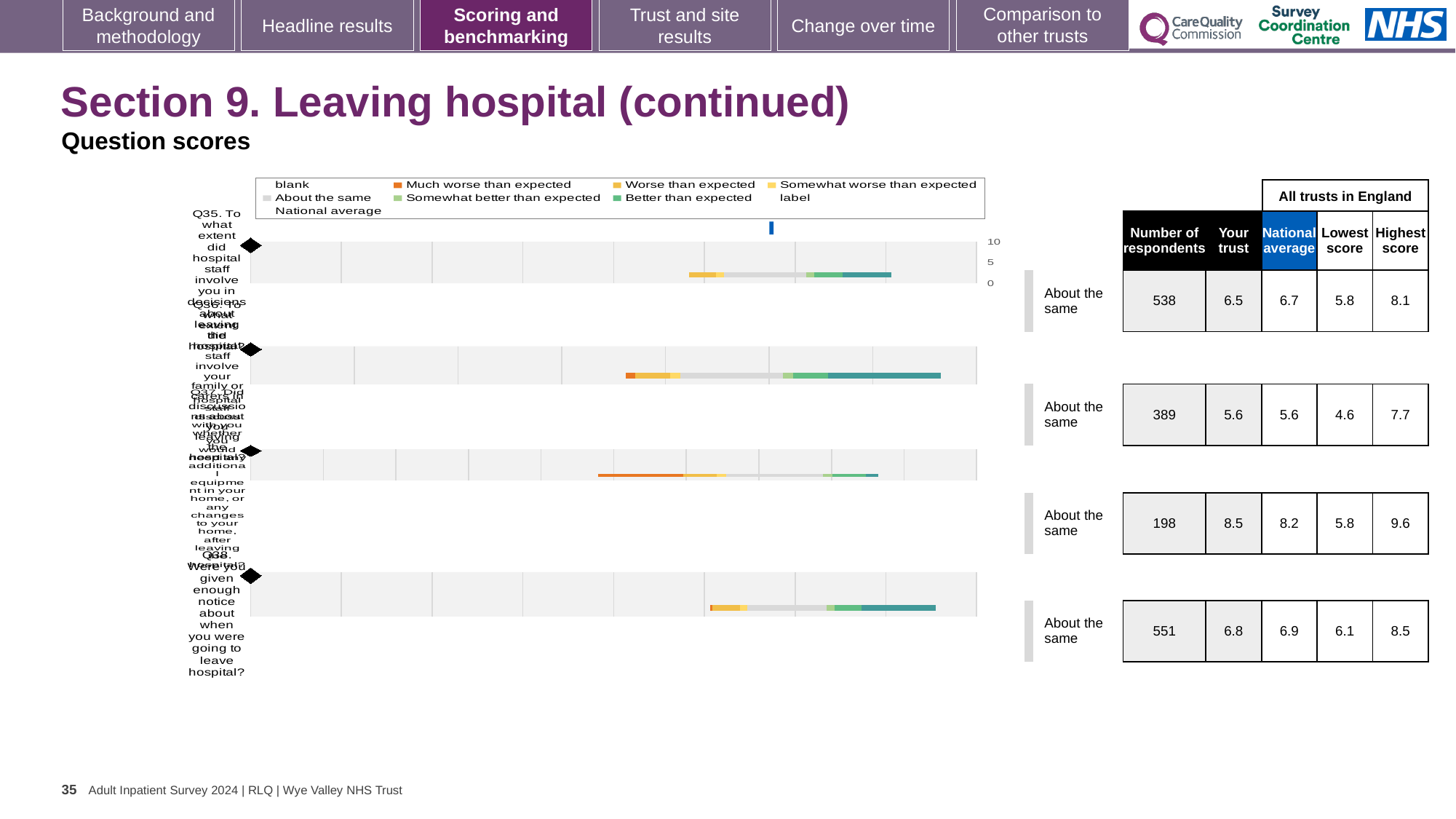
For Q35 (the first row), which is larger: the 'Your trust' score or the national average? National average What benchmark category is shown for Q38 (the last row)? About the same How many respondents are listed for Q37 (the third row)? 198 For Q37 (the third row), what is the difference between the highest score and the lowest score across all trusts in England? 3.8 Which question has the lowest 'Your trust' score? Q36 What is the lowest score across all trusts in England for Q36 (the second row)? 4.6 Which question has the highest 'Your trust' score? Q37 How many questions (rows) are plotted in the chart? 4 What is the national average for Q38 (the last row)? 6.9 For Q38 (the last row), what is the difference between the national average and the 'Your trust' score? 0.1 What is the 'Your trust' score for Q35 (the first row)? 6.5 What kind of chart is shown on the slide? bar chart